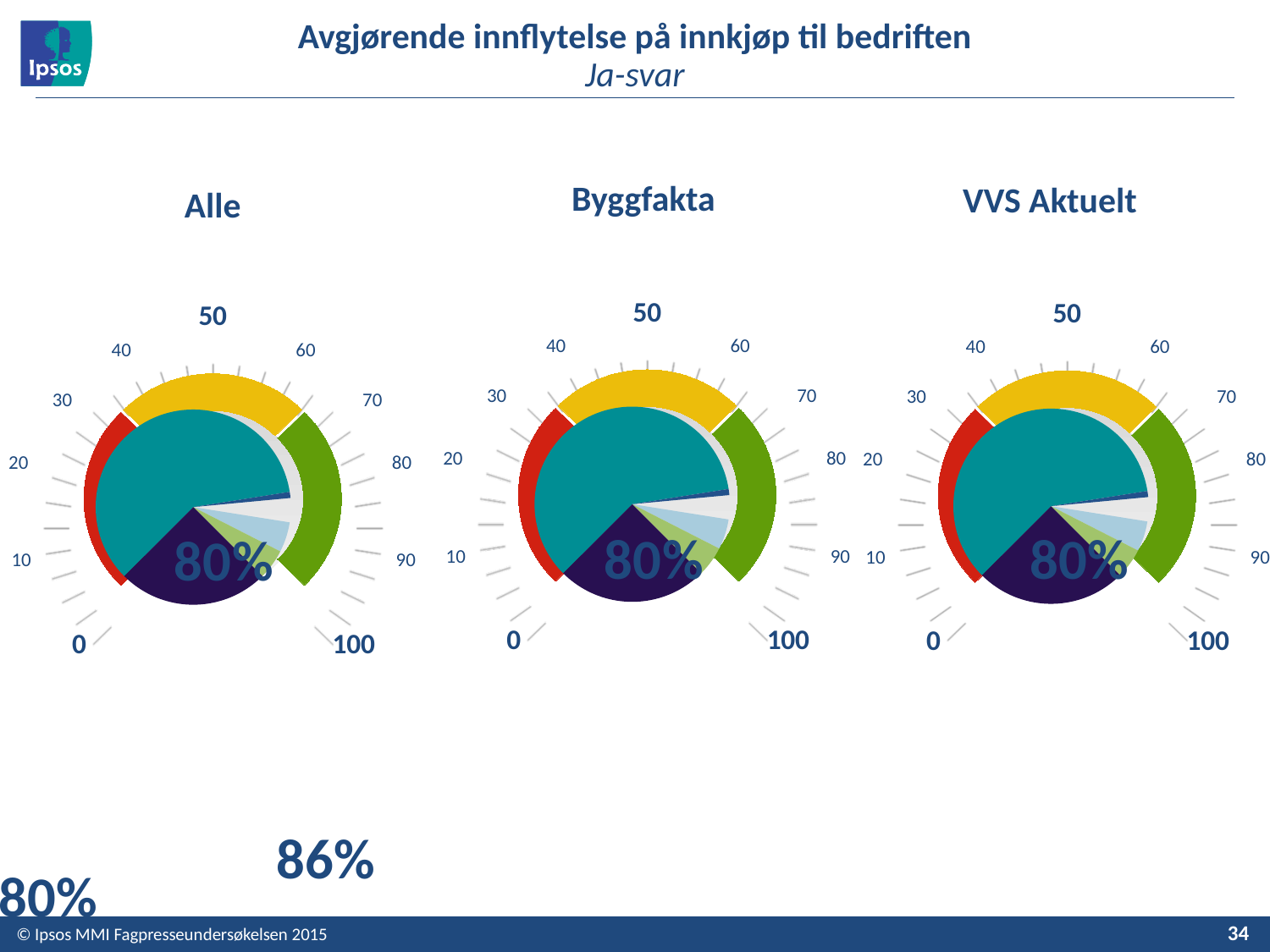
How many gauge charts are shown on the slide? 3 What is the minimum value marked on the scale of the 'VVS Aktuelt' gauge? 0 What value is displayed in the centre of the 'Byggfakta' gauge? 80% Is the value shown on the 'VVS Aktuelt' gauge greater or less than 70? greater What value is displayed in the centre of the 'Alle' gauge? 80% Is the value shown on the 'Alle' gauge greater or less than 50? greater What value is displayed in the centre of the 'VVS Aktuelt' gauge? 80% Is the value shown on the 'Byggfakta' gauge greater or less than 90? less What is the difference between the values shown on the 'Alle' and 'Byggfakta' gauges? 0 What kind of chart is used to show the 'Alle' result? Gauge chart What is the maximum value marked on the scale of the 'Byggfakta' gauge? 100 Which gauge is positioned in the middle of the slide? Byggfakta